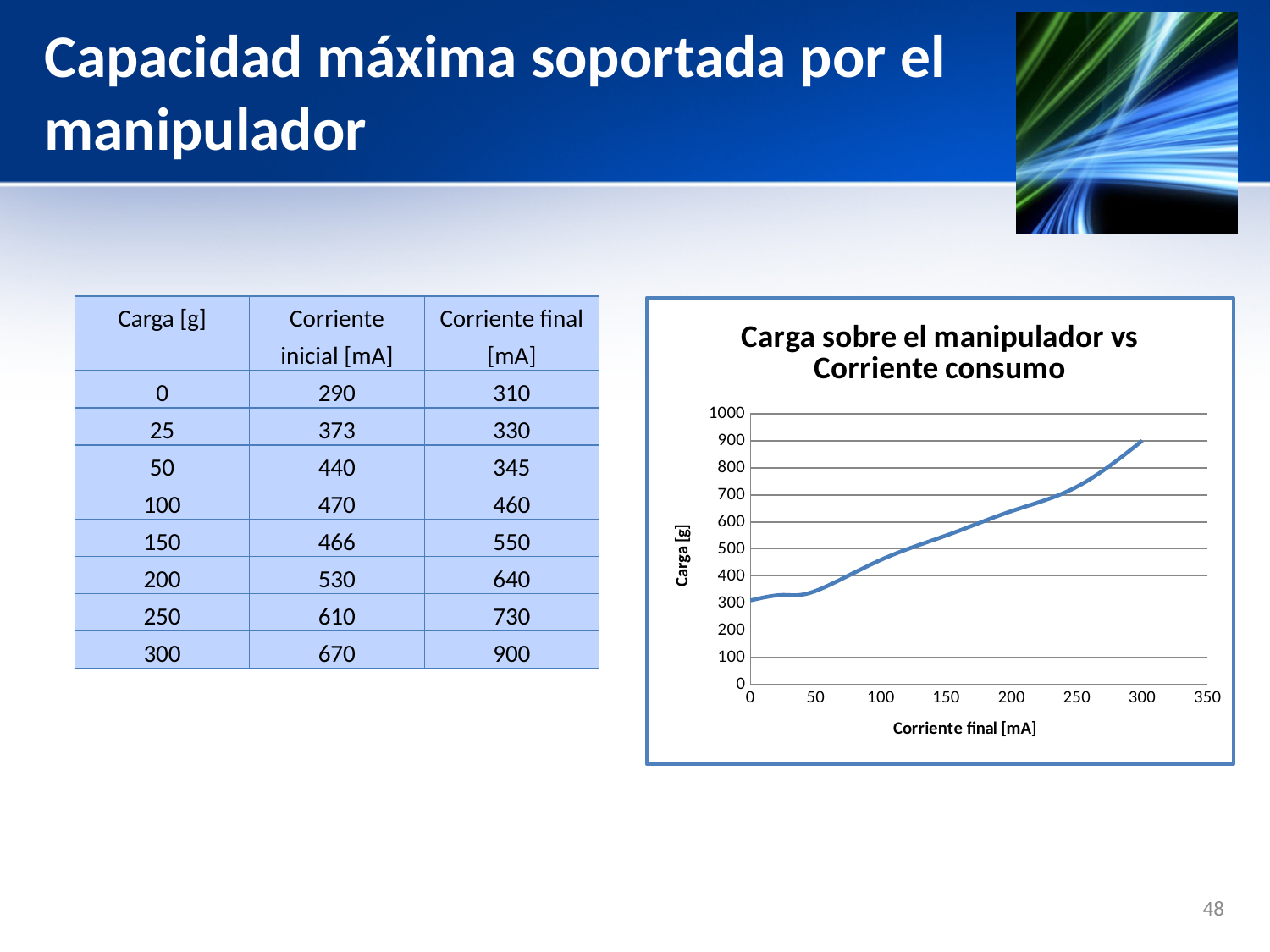
Is the value of the line at x = 50 greater or less than 400? less Does the plotted line rise or fall as the x axis increases? rises At which x value does the line reach its highest point? 300 Is the value of the line at x = 100 greater or less than 500? less What kind of chart is shown on the slide? line chart What is the title of the chart? Carga sobre el manipulador vs Corriente consumo What is the label of the chart's x axis? Corriente final [mA] Is the value of the line at x = 150 greater or less than 500? greater Is the value of the line at x = 300 larger or smaller than its value at x = 100? larger What value does the line reach at x = 300 on the chart? 900